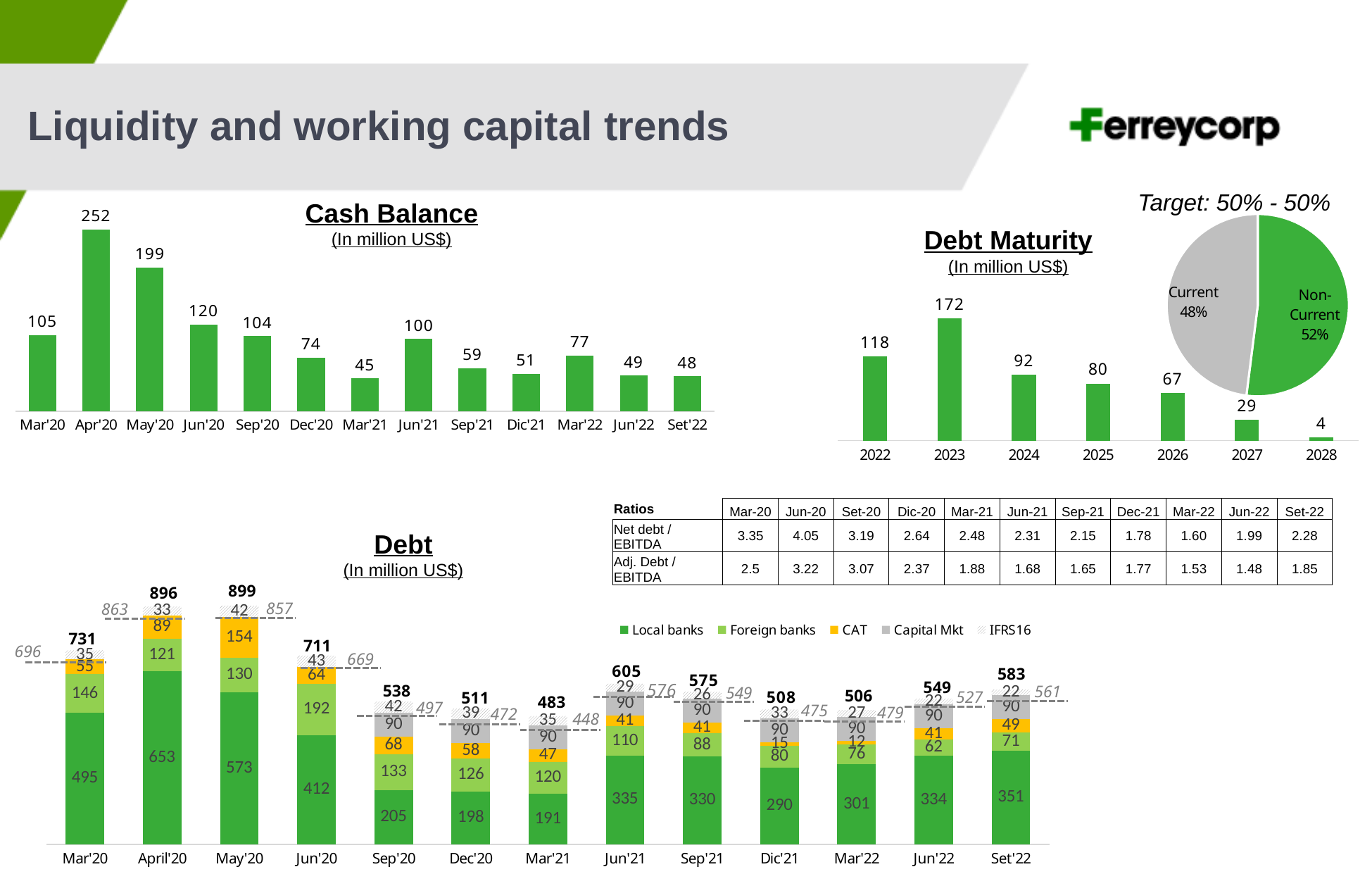
In the Debt chart, what is the total debt for Mar'20? 731 In the Cash Balance chart, which period has the highest cash balance? Apr'20 In the Cash Balance chart, what is the difference between the values for Mar'20 and Set'22? 57 In the Debt chart, what is the Local banks value for Set'22? 351 In the Cash Balance chart, what is the value for Apr'20? 252 In the Debt Maturity chart, do the values rise or fall from 2023 to 2028? fall How many series does the legend of the Debt chart list? 5 In the Debt Maturity chart, which year has the lowest value? 2028 In the Debt Maturity chart, what is the value for 2023? 172 How many periods are shown in the Cash Balance chart? 13 In the Cash Balance chart, which period has the lowest cash balance? Mar'21 In the pie chart next to Debt Maturity, what share is Non-Current? 52%